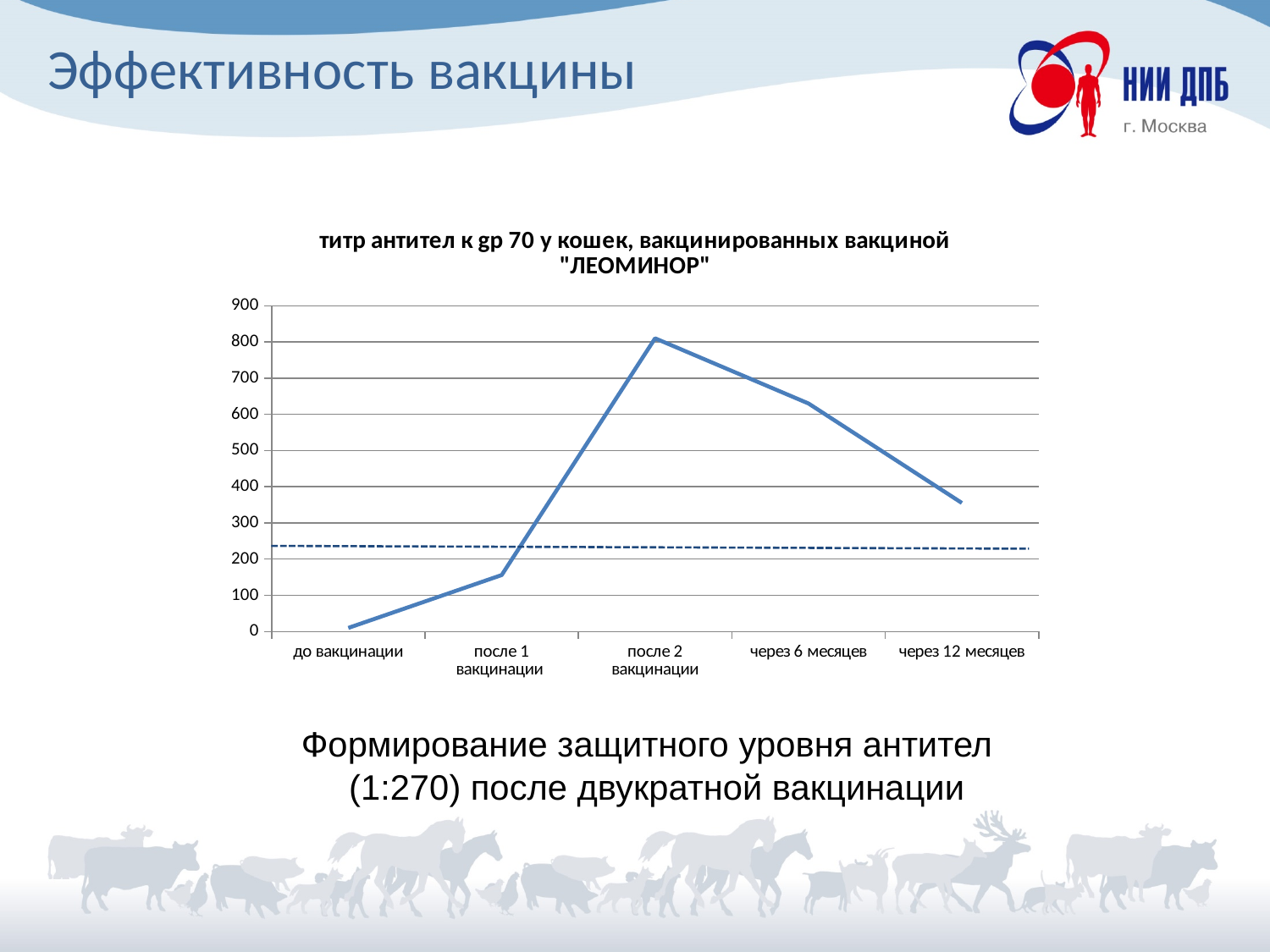
Is the value for "после 2 вакцинации" greater or less than 700? greater Which is larger, the value for "через 6 месяцев" or the value for "через 12 месяцев"? через 6 месяцев Which category has the highest antibody titre value on the chart? после 2 вакцинации Is the value for "через 12 месяцев" greater or less than 300? greater Does the solid line rise or fall between "после 2 вакцинации" and "через 12 месяцев"? fall Is the value for "после 1 вакцинации" greater or less than 200? less How many categories are shown along the x axis of the chart? 5 What is the title of the chart? титр антител к gp 70 у кошек, вакцинированных вакциной "ЛЕОМИНОР" What kind of chart is shown on the slide? line chart Which category has the lowest antibody titre value on the chart? до вакцинации Does the solid line rise or fall between "до вакцинации" and "после 2 вакцинации"? rise